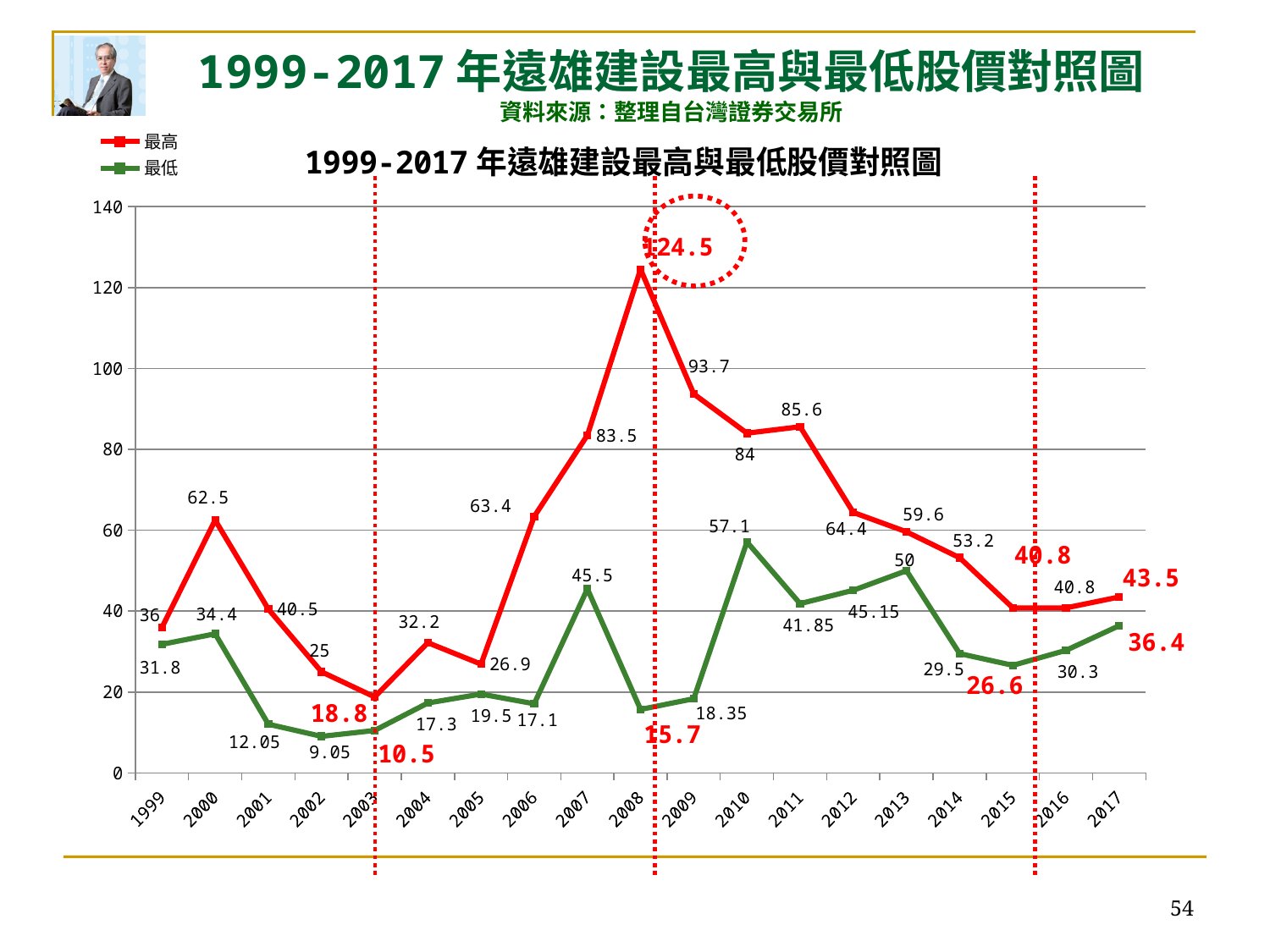
What is the value of the 最低 series in 2003? 10.5 Which is larger, the 最高 value in 2009 or the 最高 value in 2011? 2009 What is the difference between the 最高 and 最低 values in 2017? 7.1 What is the value of the 最低 series in 2010? 57.1 Does the 最高 series rise or fall from 2008 to 2015? fall What colour is the line for the 最低 series? green In which year does the 最高 series reach its highest value? 2008 How many series does the legend list? 2 In which year does the 最低 series reach its lowest value? 2002 What type of chart is shown on the slide? line chart How many years are plotted along the x axis? 19 What is the value of the 最高 series in 2008? 124.5